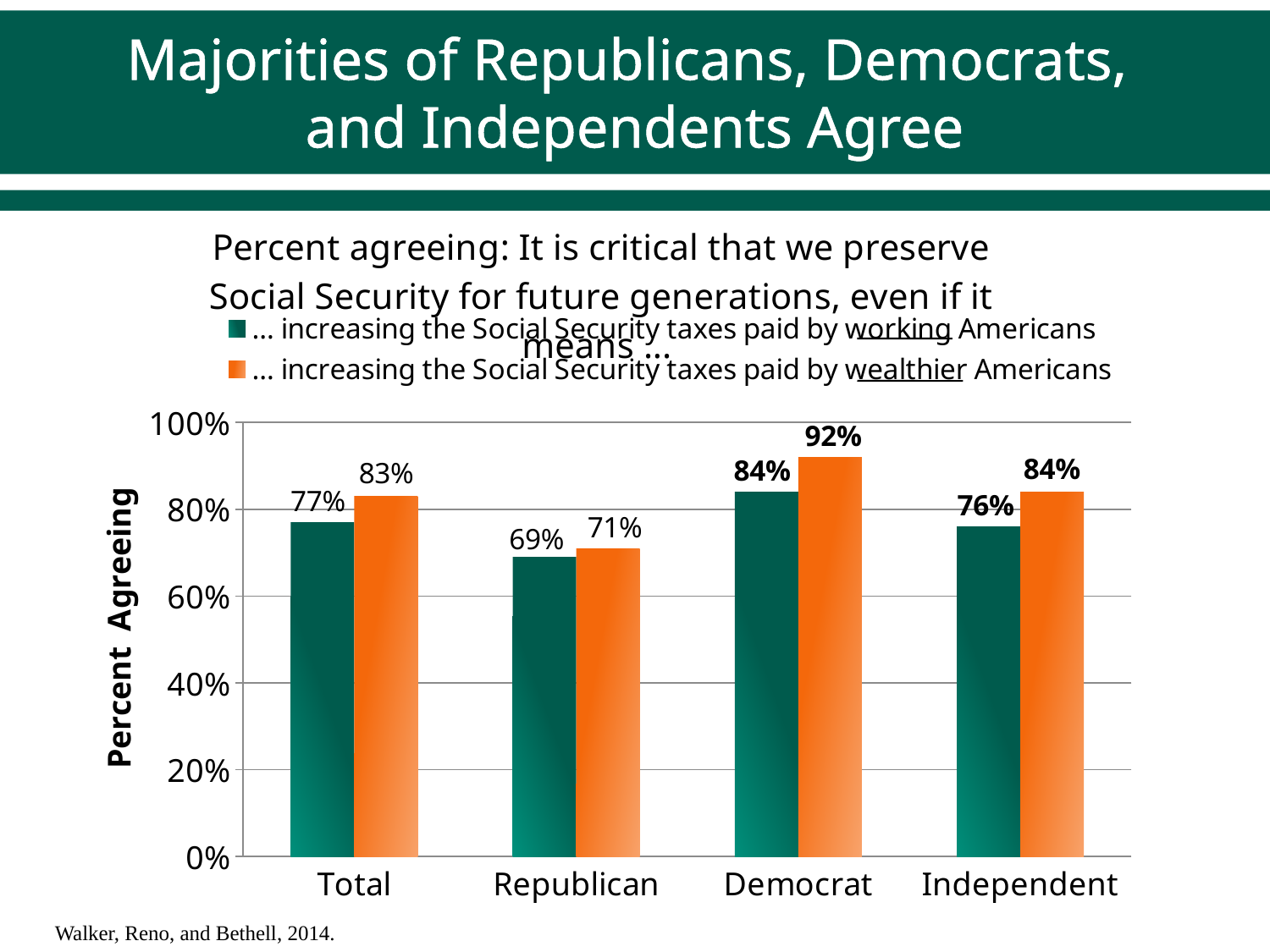
How many categories are shown on the x axis? 4 What kind of chart is shown on the slide? bar chart How many series does the legend list? 2 What is the difference between the Total values for the 'wealthier Americans' and 'working Americans' series? 6% What percent of Democrats agree with increasing Social Security taxes paid by wealthier Americans? 92% What is the value for Independents in the 'working Americans' series? 76% Is the 'wealthier Americans' value for Republicans greater or less than 80%? less What percent of Republicans agree with increasing Social Security taxes paid by working Americans? 69% Which category has the lowest value for the 'working Americans' series? Republican Which category has the highest value for the 'wealthier Americans' series? Democrat What is the difference between the 'wealthier Americans' and 'working Americans' values for Democrats? 8% Which is larger: the 'working Americans' value for Democrats or for Independents? Democrats